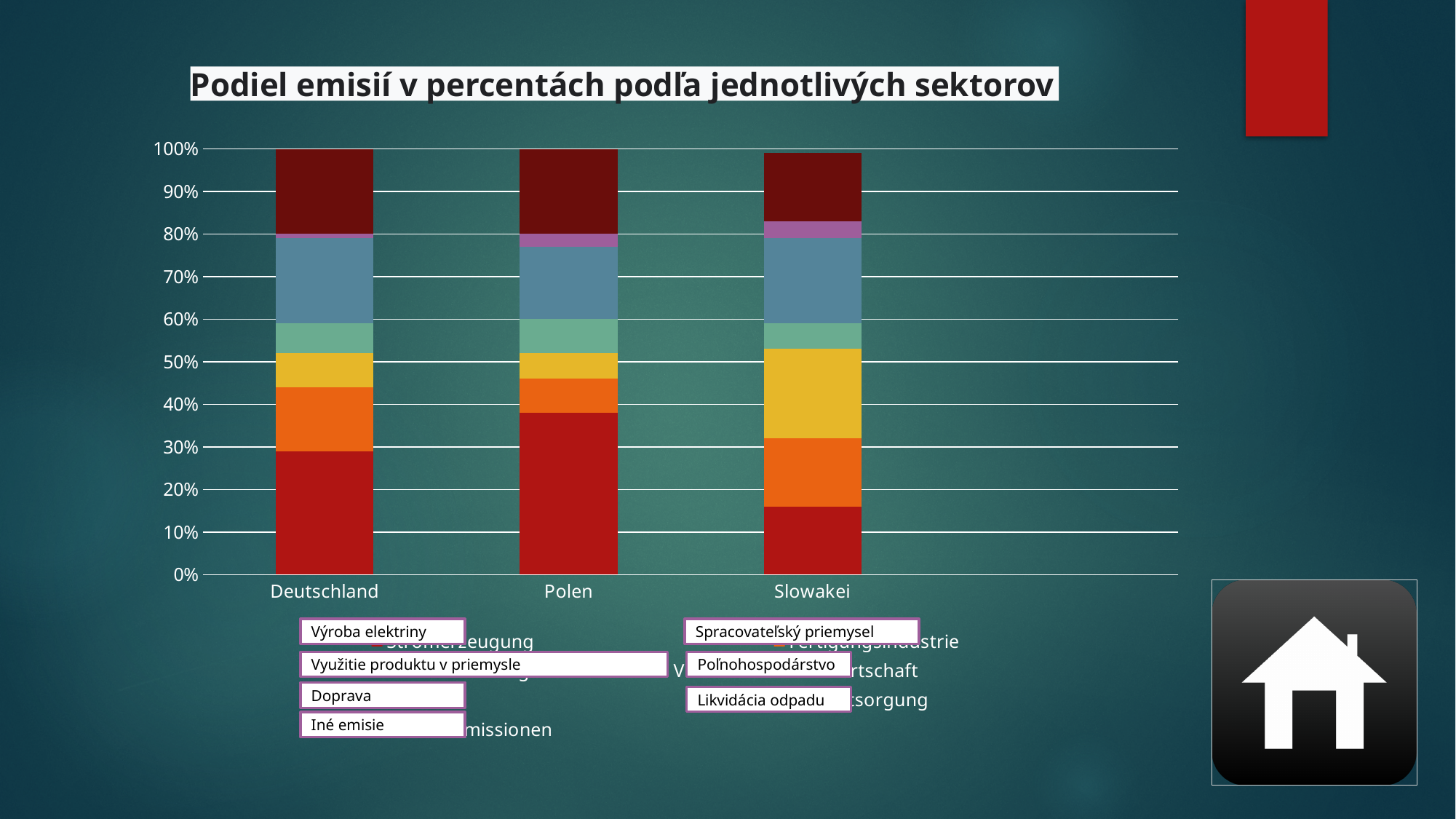
Which countries are shown on the x axis of the chart? Deutschland, Polen, Slowakei What is the title of the chart? Podiel emisií v percentách podľa jednotlivých sektorov How many series does the chart's legend list? 7 Which country has the larger bottom (red) segment, Deutschland or Polen? Polen Which country has the largest bottom (red) segment in its bar? Polen Is the bottom (red) segment of the Slowakei bar greater or less than 10%? greater Is the bottom (red) segment of the Polen bar greater or less than 30%? greater How many countries (categories) are shown on the x axis of the chart? 3 Is the bottom (red) segment of the Slowakei bar greater or less than 20%? less Which country has the larger yellow segment, Deutschland or Slowakei? Slowakei What kind of chart is shown on the slide? stacked bar chart